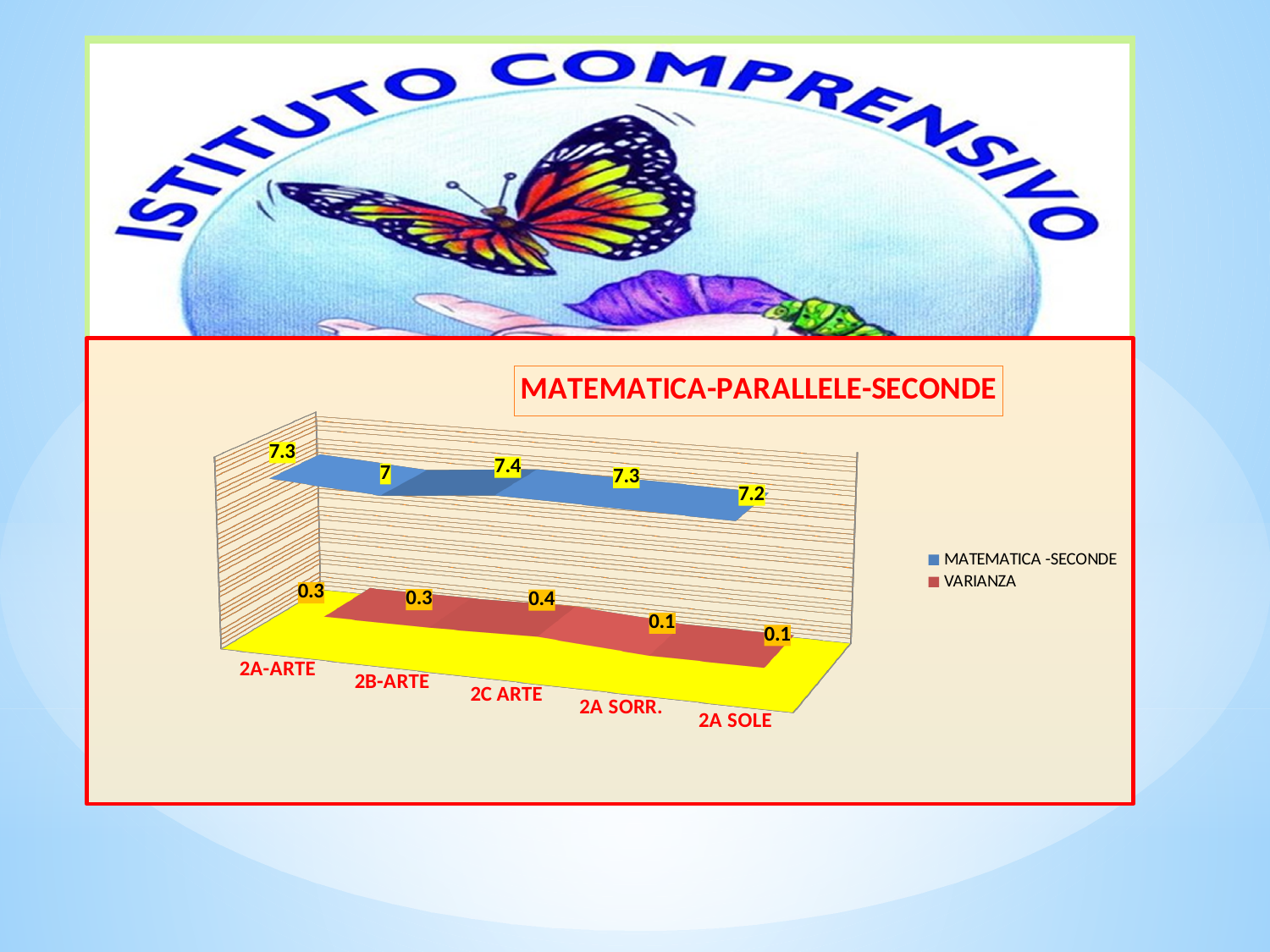
Which is larger, the VARIANZA value for 2A-ARTE or for 2A SOLE? 2A-ARTE What is the MATEMATICA -SECONDE value for 2B-ARTE? 7 Which category has the highest VARIANZA value? 2C ARTE What is the difference between the MATEMATICA -SECONDE values for 2C ARTE and 2B-ARTE? 0.4 What is the title of the chart? MATEMATICA-PARALLELE-SECONDE Which category has the lowest MATEMATICA -SECONDE value? 2B-ARTE What kind of chart is shown on the slide? 3D line chart What is the VARIANZA value for 2A SORR.? 0.1 What is the MATEMATICA -SECONDE value for 2C ARTE? 7.4 How many categories are shown on the x axis of the chart? 5 How many series does the legend list? 2 Which category has the highest MATEMATICA -SECONDE value? 2C ARTE